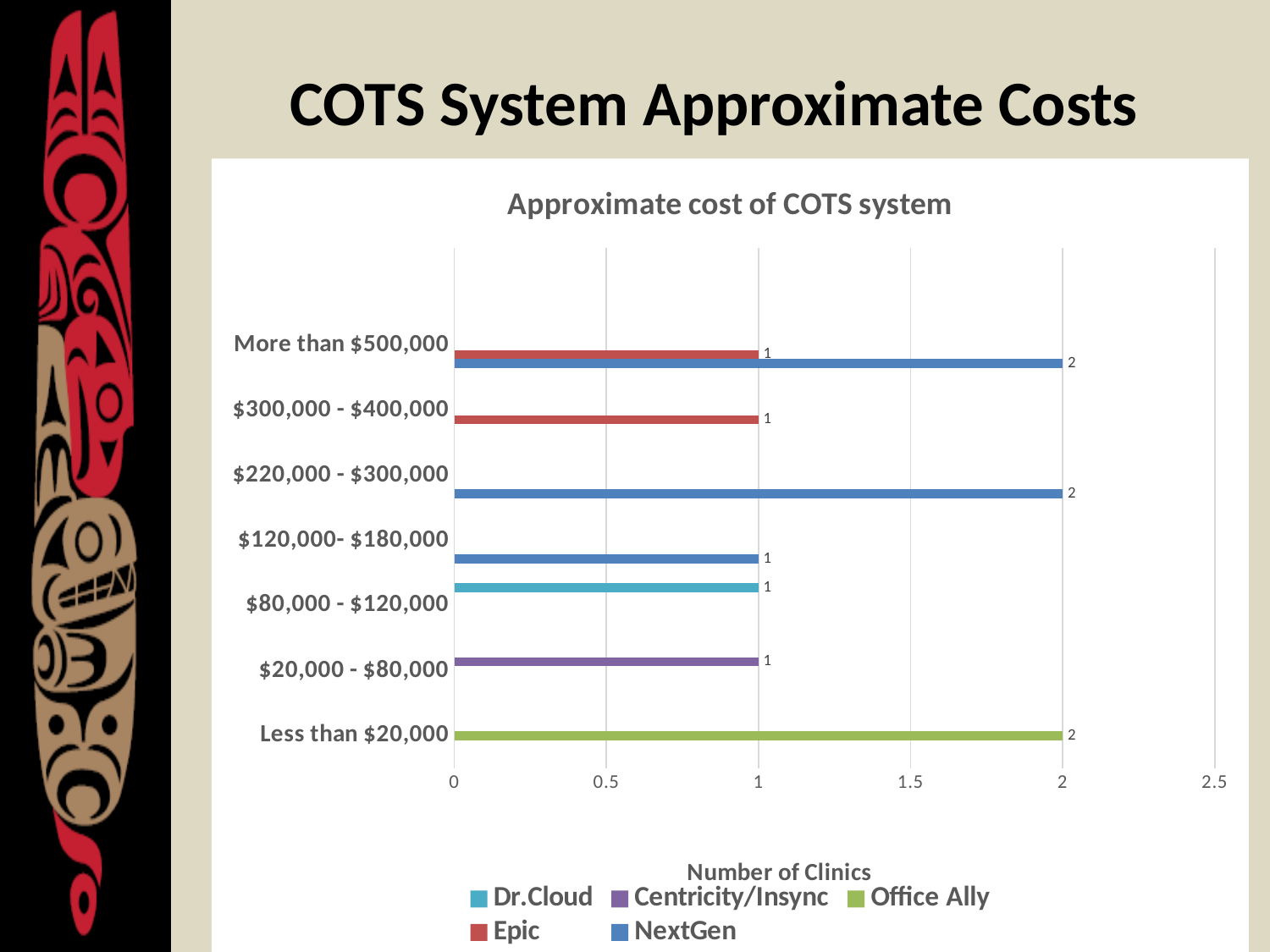
What is the label of the horizontal axis? Number of Clinics What is the difference between the NextGen value and the Epic value in the 'More than $500,000' category? 1 How many clinics use Dr.Cloud in the '$80,000 - $120,000' category? 1 How many clinics use NextGen in the 'More than $500,000' category? 2 How many cost categories are shown on the vertical axis? 7 What is the title of the chart? Approximate cost of COTS system How many clinics use Office Ally in the 'Less than $20,000' category? 2 How many series does the legend list? 5 In the 'More than $500,000' category, which is larger: the Epic value or the NextGen value? NextGen Which series has a bar in the '$20,000 - $80,000' category? Centricity/Insync What type of chart is shown on the slide? Bar chart How many clinics use Epic in the '$300,000 - $400,000' category? 1